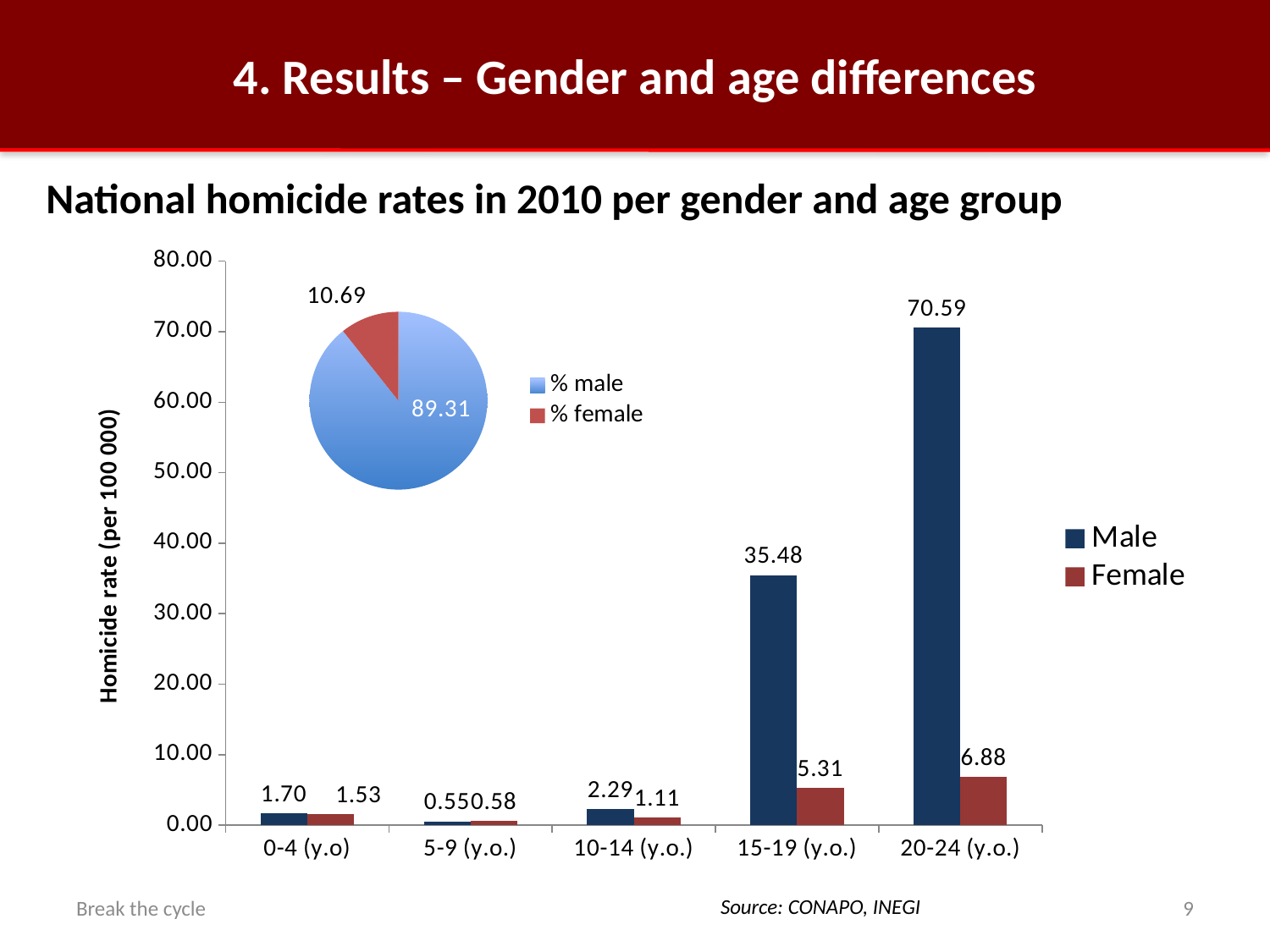
In the pie chart, what share is labelled for % male? 89.31 In the bar chart, what is the difference between the Male and Female values for the 20-24 (y.o.) age group? 63.71 What is the y-axis label of the bar chart? Homicide rate (per 100 000) In the bar chart, which age group has the lowest Female homicide rate? 5-9 (y.o.) In the bar chart, how many series does the legend list? 2 In the bar chart, what is the Male homicide rate for the 20-24 (y.o.) age group? 70.59 In the bar chart, which age group has the highest Male homicide rate? 20-24 (y.o.) In the pie chart, what value is shown for % female? 10.69 In the bar chart, which is larger for the 15-19 (y.o.) age group, the Male or the Female value? Male In the bar chart, what is the Female homicide rate for the 15-19 (y.o.) age group? 5.31 In the bar chart, how many age groups are shown on the x axis? 5 In the bar chart, what is the Male value for the 10-14 (y.o.) age group? 2.29